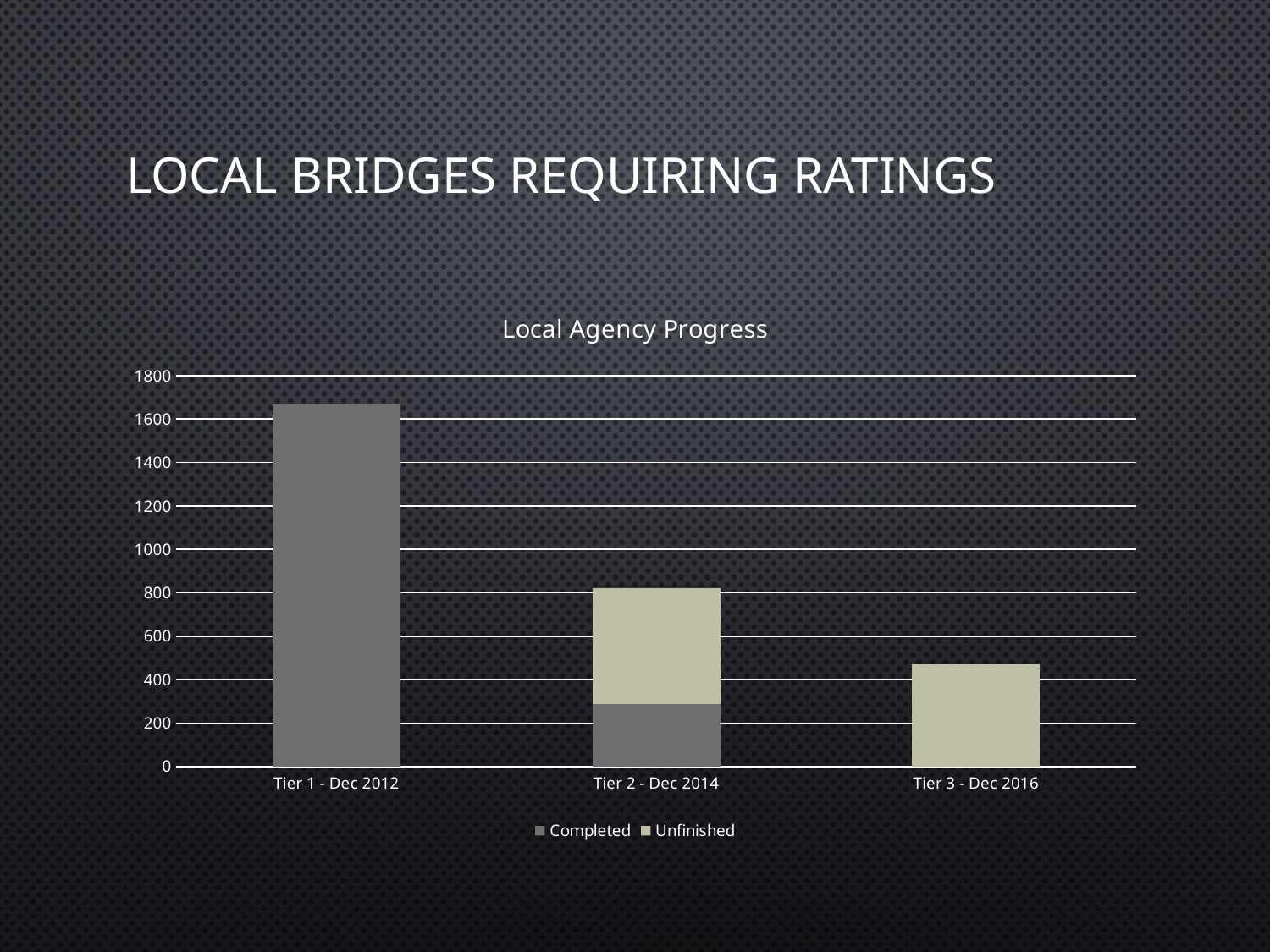
What is the title of the chart? Local Agency Progress How many categories are shown on the x axis? 3 What kind of chart is shown on the slide? bar chart Which category has the shortest bar overall? Tier 3 - Dec 2016 How many series does the legend list? 2 Is the Completed value for Tier 1 - Dec 2012 greater or less than 1600? greater Which series is shown in the lighter colour in the legend? Unfinished Is the Completed value for Tier 2 - Dec 2014 greater or less than 400? less Which is larger, the Completed value for Tier 1 - Dec 2012 or the Completed value for Tier 2 - Dec 2014? Tier 1 - Dec 2012 Which category has the tallest bar overall? Tier 1 - Dec 2012 Is the Unfinished value for Tier 3 - Dec 2016 greater or less than 400? greater